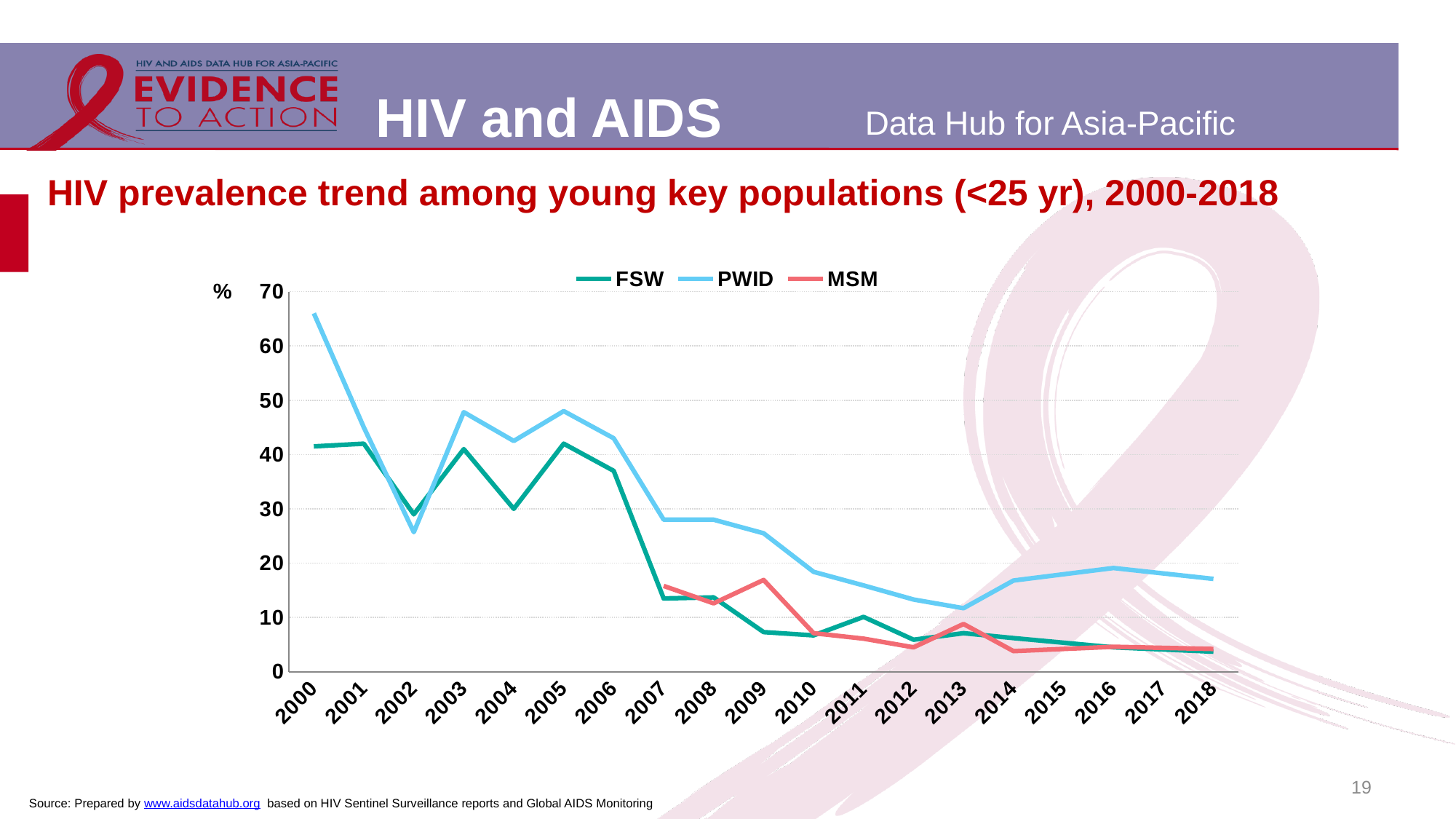
Is the value for MSM in 2009 greater or less than 10? greater What is the title of the chart? HIV prevalence trend among young key populations (<25 yr), 2000-2018 What kind of chart is shown on the slide? line chart Which series has the highest value in 2018? PWID In which year does the PWID series reach its highest value? 2000 How many series does the legend list? 3 Which is larger in 2005, the value for PWID or the value for FSW? PWID Which series has the highest value in 2000? PWID Is the value for FSW in 2018 greater or less than 10? less Is the value for PWID in 2000 greater or less than 60? greater How many years are plotted along the x axis? 19 Does the FSW series rise or fall overall from 2006 to 2018? fall